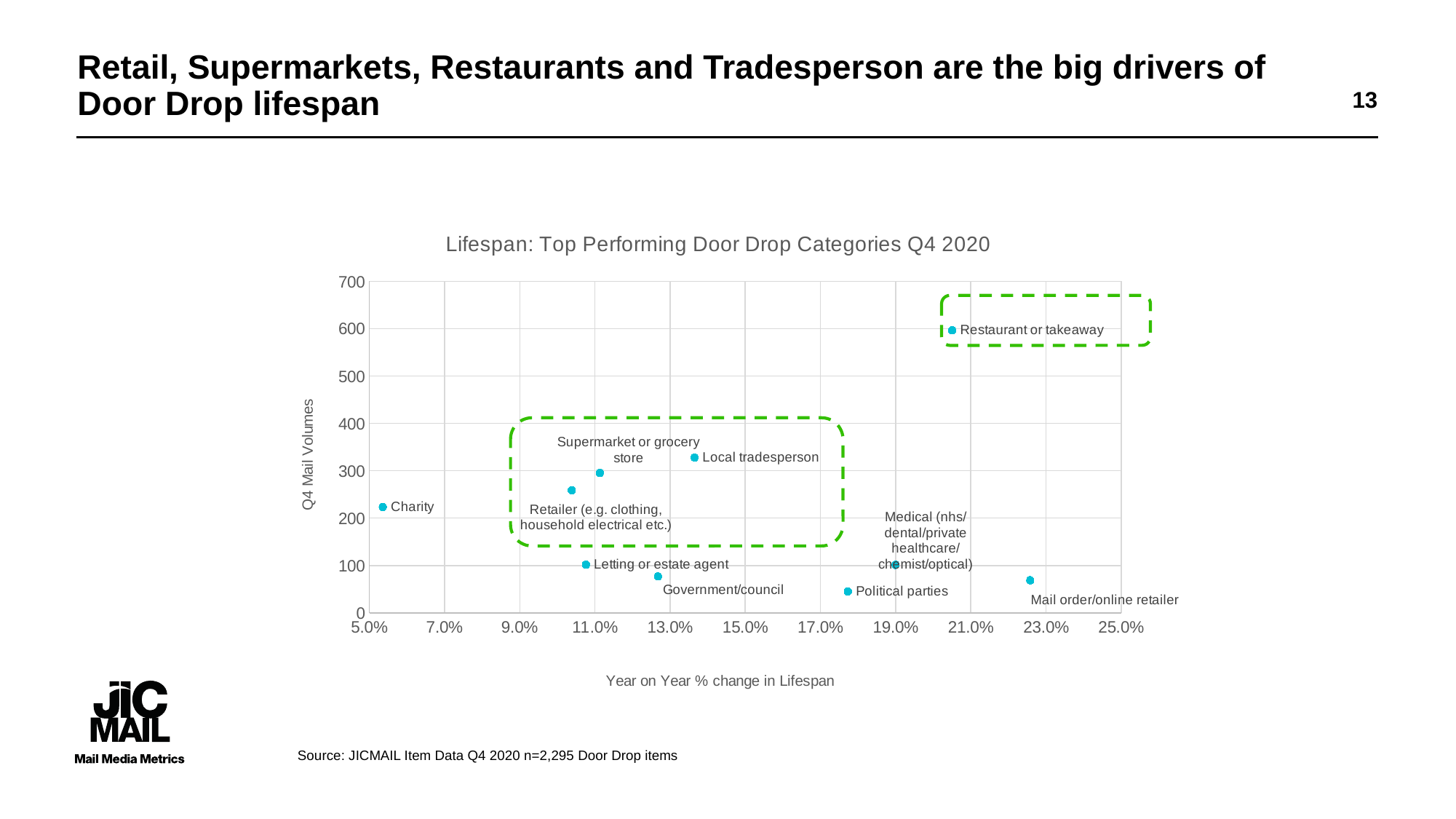
Is the Q4 Mail Volumes value for Letting or estate agent greater or less than 200? less Which category has the lowest Q4 Mail Volumes? Political parties Which category has the highest Year on Year % change in Lifespan? Mail order/online retailer Is the Q4 Mail Volumes value for Restaurant or takeaway greater or less than 500? greater Which has higher Q4 Mail Volumes, Local tradesperson or Government/council? Local tradesperson What is the title of the chart? Lifespan: Top Performing Door Drop Categories Q4 2020 Which category has the highest Q4 Mail Volumes? Restaurant or takeaway How many categories are plotted on the chart? 10 Which category has the lowest Year on Year % change in Lifespan? Charity What is the label of the x axis? Year on Year % change in Lifespan What kind of chart is shown on the slide? Scatter chart Is the Q4 Mail Volumes value for Charity greater or less than 300? less